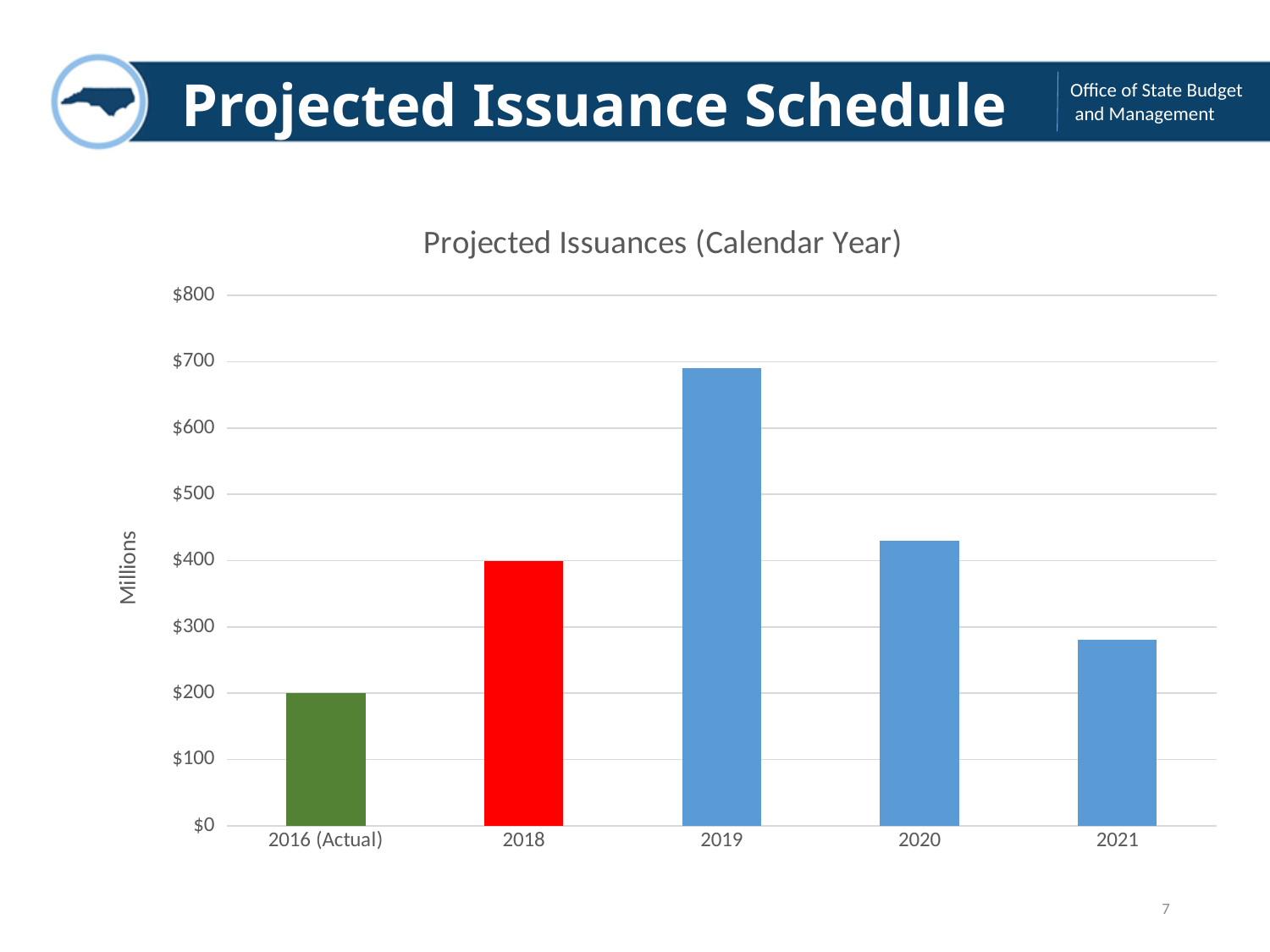
Which year has the lowest issuance value? 2016 (Actual) Which is larger, the value for 2020 or the value for 2021? 2020 What kind of chart is shown on the slide? Bar chart How many years (categories) are shown on the x axis? 5 Is the value for 2019 greater or less than $600? greater What is the value for 2016 (Actual)? $200 What is the title of the chart? Projected Issuances (Calendar Year) What is the value for 2018? $400 Is the value for 2021 greater or less than $300? less What label is shown on the vertical axis? Millions Do the values rise or fall from 2019 to 2021? Fall Which year has the highest projected issuance? 2019